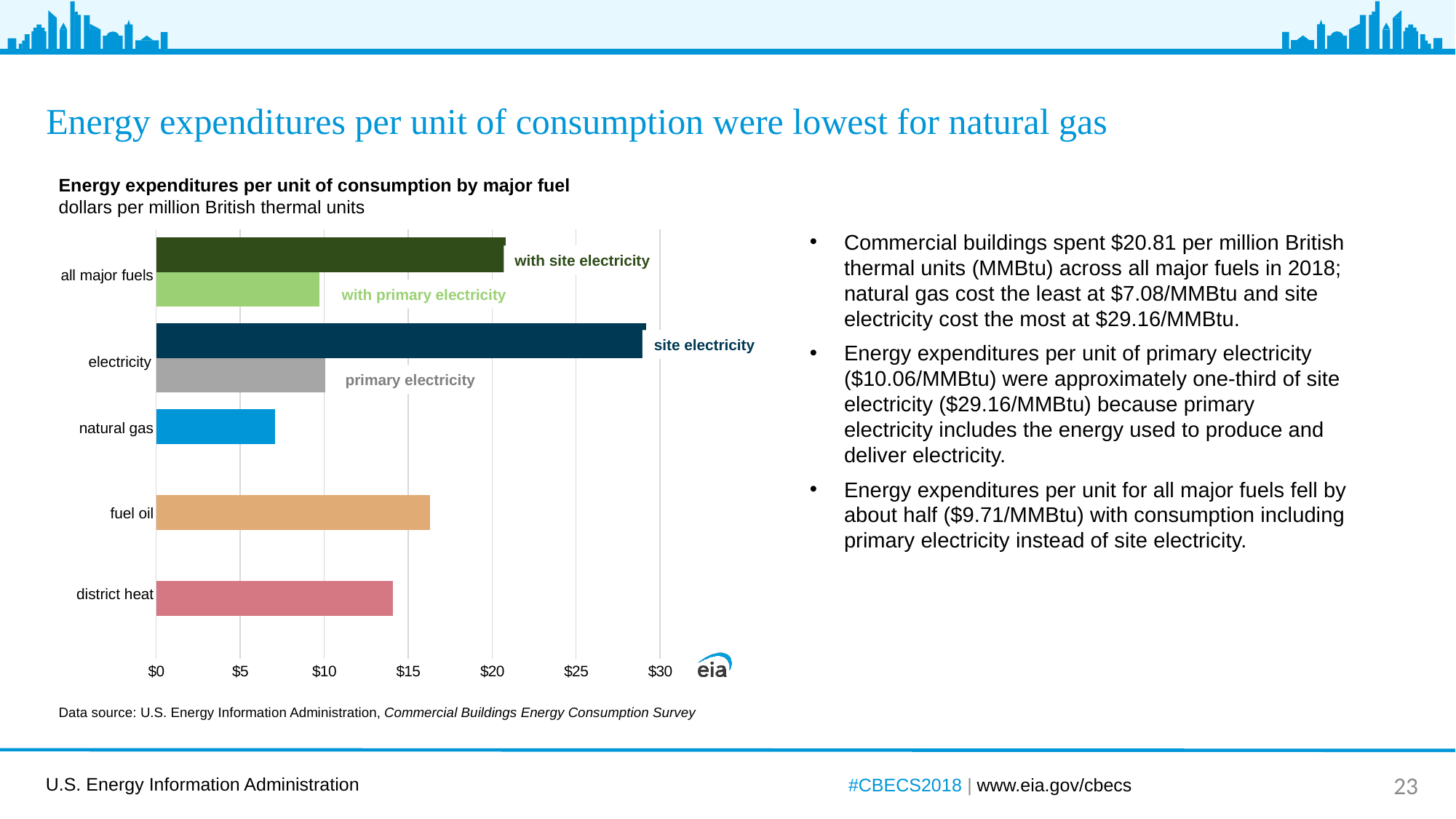
What is the energy expenditure per unit of consumption for natural gas? $7.08/MMBtu Is the value for fuel oil greater or less than $15? greater Which fuel category has the lowest energy expenditure per unit of consumption? natural gas What is the energy expenditure per unit of consumption for site electricity? $29.16/MMBtu Which is larger, the value for fuel oil or the value for district heat? fuel oil What is the title of the chart? Energy expenditures per unit of consumption by major fuel How many fuel categories are listed on the vertical axis of the chart? 5 What kind of chart is shown on the slide? bar chart In what units are the values on the chart expressed? dollars per million British thermal units Which bar on the chart is the longest? site electricity Is the value for district heat greater or less than $15? less What is the energy expenditure per unit of consumption for primary electricity? $10.06/MMBtu